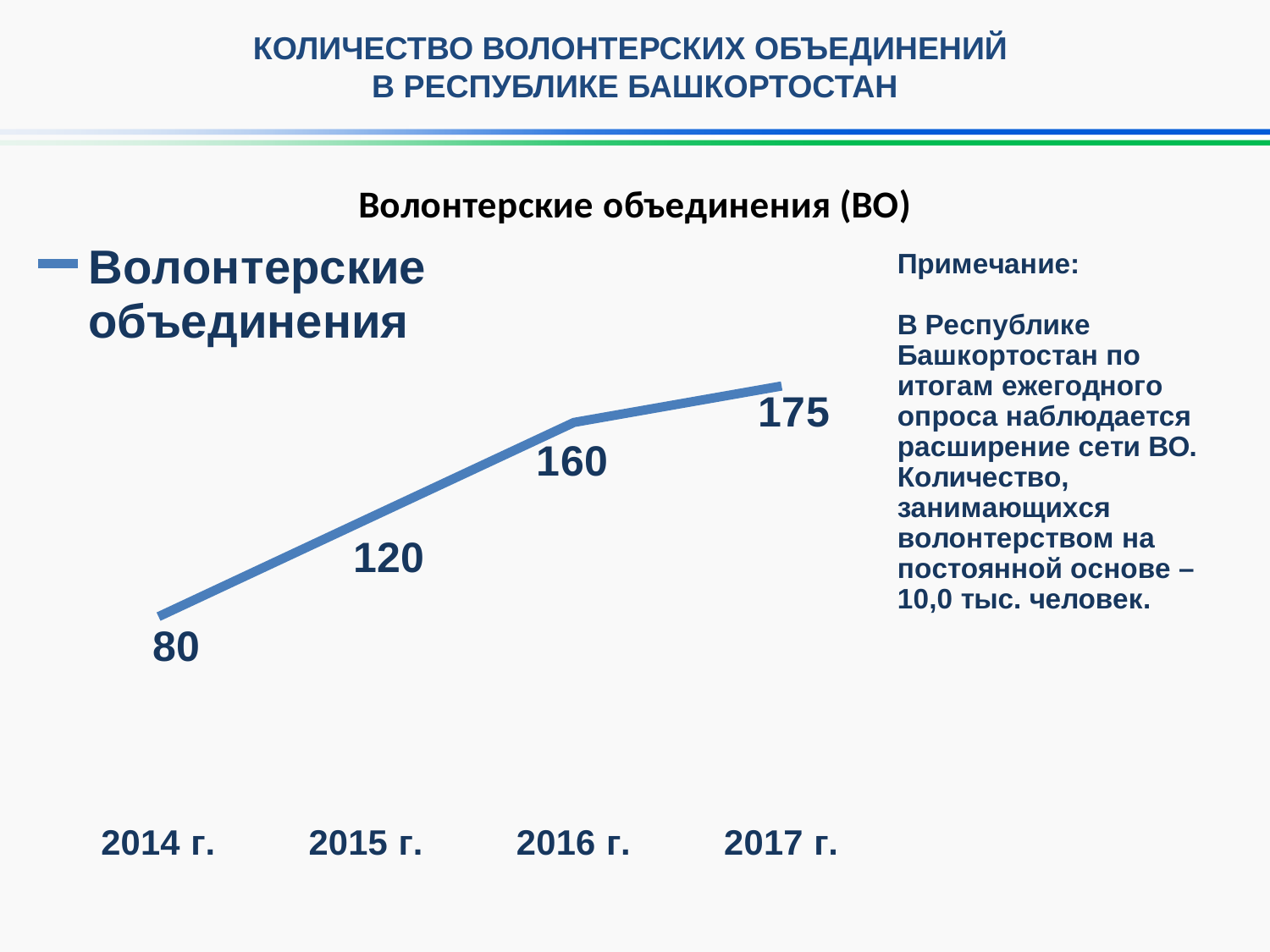
Which year has the highest value? 2017 г. What is the difference between the values for 2017 г. and 2014 г.? 95 What is the value for 2014 г.? 80 What is the difference between the values for 2016 г. and 2015 г.? 40 What is the value for 2016 г.? 160 Do the values rise or fall from 2014 г. to 2017 г.? rise What is the value for 2017 г.? 175 Which year has the lowest value? 2014 г. What kind of chart is shown? line chart How many years are plotted on the chart? 4 What is the value for 2015 г.? 120 Which is larger, the value for 2015 г. or the value for 2016 г.? 2016 г.